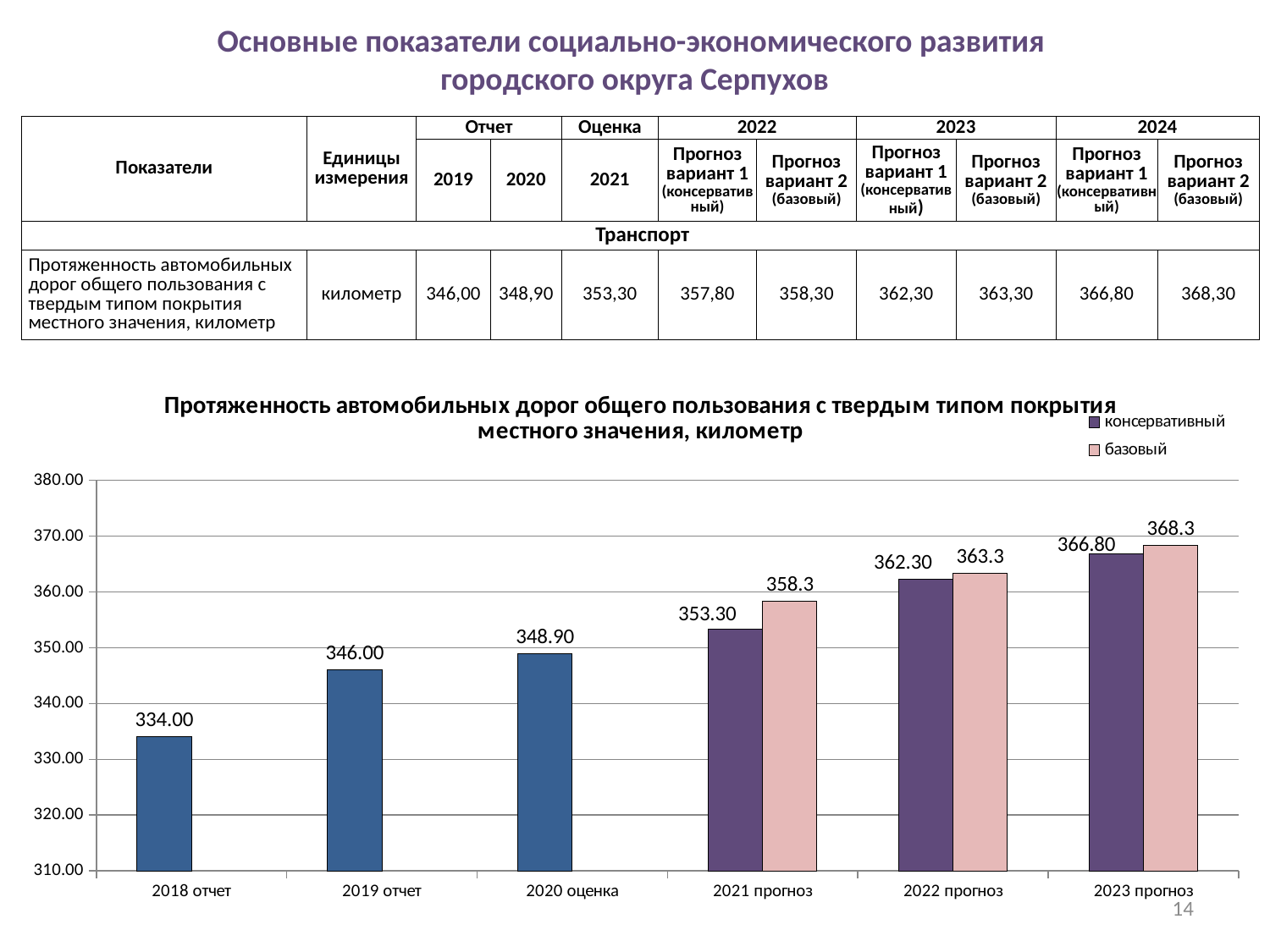
Do the values rise or fall from 2018 отчет to 2023 прогноз? rise Which is larger for 2023 прогноз: the консервативный or the базовый value? базовый What is the difference between the values for 2019 отчет and 2018 отчет? 12.00 What is the value of the bar for 2018 отчет? 334.00 What is the difference between the базовый and консервативный values for 2021 прогноз? 5.0 How many categories are shown on the x axis of the chart? 6 Which bar is the highest in the chart? базовый for 2023 прогноз (368.3) How many series does the chart legend list? 2 What is the value of the bar for 2020 оценка? 348.90 What is the value of the консервативный bar for 2022 прогноз? 362.30 Which category has the lowest bar in the chart? 2018 отчет What is the value of the базовый bar for 2021 прогноз? 358.3